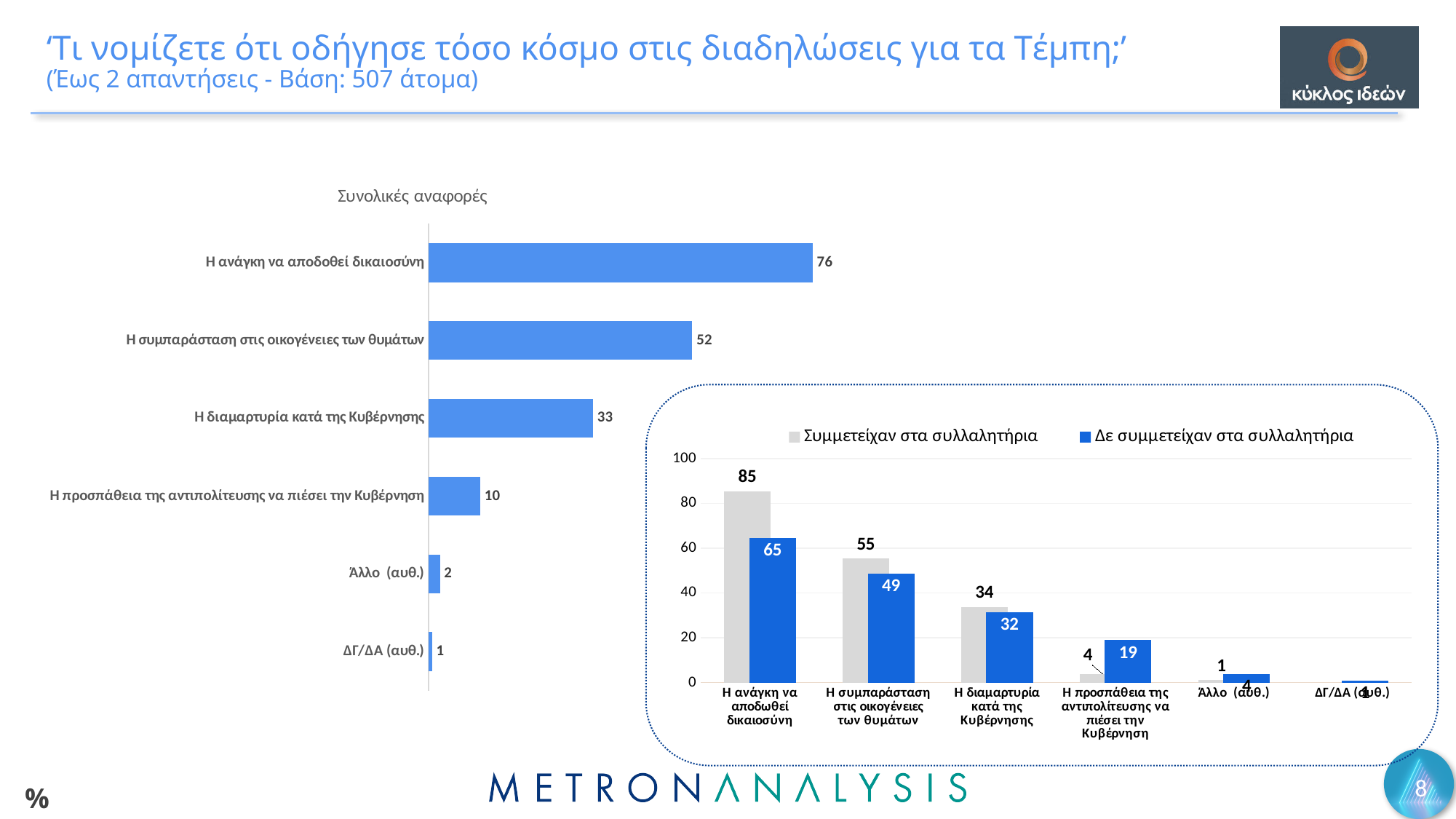
In the right chart, what is the difference between the two series for 'Η ανάγκη να αποδοθεί δικαιοσύνη'? 20 In the left chart 'Συνολικές αναφορές', what is the difference between 'Η ανάγκη να αποδοθεί δικαιοσύνη' and 'Η συμπαράσταση στις οικογένειες των θυμάτων'? 24 In the right chart, how many series does the legend list? 2 In the right chart, for 'Η συμπαράσταση στις οικογένειες των θυμάτων', which series has the larger value: 'Συμμετείχαν στα συλλαλητήρια' or 'Δε συμμετείχαν στα συλλαλητήρια'? Συμμετείχαν στα συλλαλητήρια In the left chart 'Συνολικές αναφορές', which category has the lowest value? ΔΓ/ΔΑ (αυθ.) In the left chart 'Συνολικές αναφορές', what is the value for 'Η ανάγκη να αποδοθεί δικαιοσύνη'? 76 What type of chart is the left chart 'Συνολικές αναφορές'? Bar chart In the right chart, which series is shown in grey? Συμμετείχαν στα συλλαλητήρια In the right chart, what is the value of 'Δε συμμετείχαν στα συλλαλητήρια' for 'Η προσπάθεια της αντιπολίτευσης να πιέσει την Κυβέρνηση'? 19 In the left chart 'Συνολικές αναφορές', how many categories are shown? 6 In the right chart, what is the value of 'Συμμετείχαν στα συλλαλητήρια' for 'Η ανάγκη να αποδοθεί δικαιοσύνη'? 85 In the left chart 'Συνολικές αναφορές', what is the value for 'Η διαμαρτυρία κατά της Κυβέρνησης'? 33